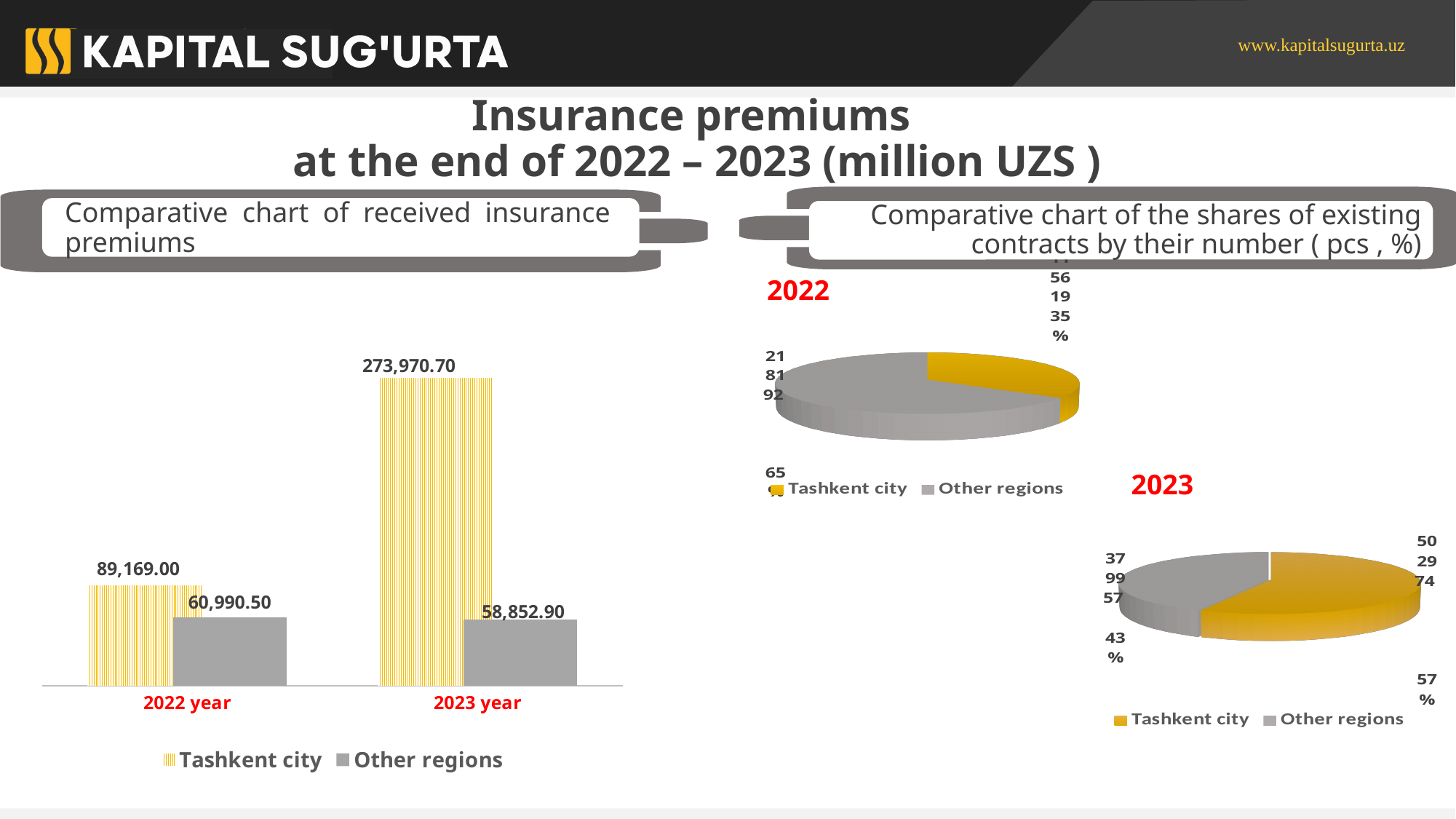
On the bar chart of received insurance premiums, how many series does the legend list? 2 On the bar chart of received insurance premiums, which bar has the lowest value? Other regions, 2023 year On the bar chart of received insurance premiums, what is the value for Tashkent city in 2023 year? 273,970.70 On the 2022 pie chart of shares of existing contracts, which slice is larger: Tashkent city or Other regions? Other regions On the bar chart of received insurance premiums, what is the value for Other regions in 2022 year? 60,990.50 On the bar chart of received insurance premiums, which bar has the highest value? Tashkent city, 2023 year On the bar chart of received insurance premiums, how many year categories are shown on the x axis? 2 What kind of chart is used for the shares of existing contracts for 2022 and 2023 on the right side of the slide? Pie chart On the bar chart of received insurance premiums, what is the value for Tashkent city in 2022 year? 89,169.00 On the bar chart of received insurance premiums, what is the difference between Tashkent city and Other regions in 2022 year? 28,178.50 On the bar chart of received insurance premiums, which is larger in 2023 year: Tashkent city or Other regions? Tashkent city On the bar chart of received insurance premiums, what is the value for Other regions in 2023 year? 58,852.90